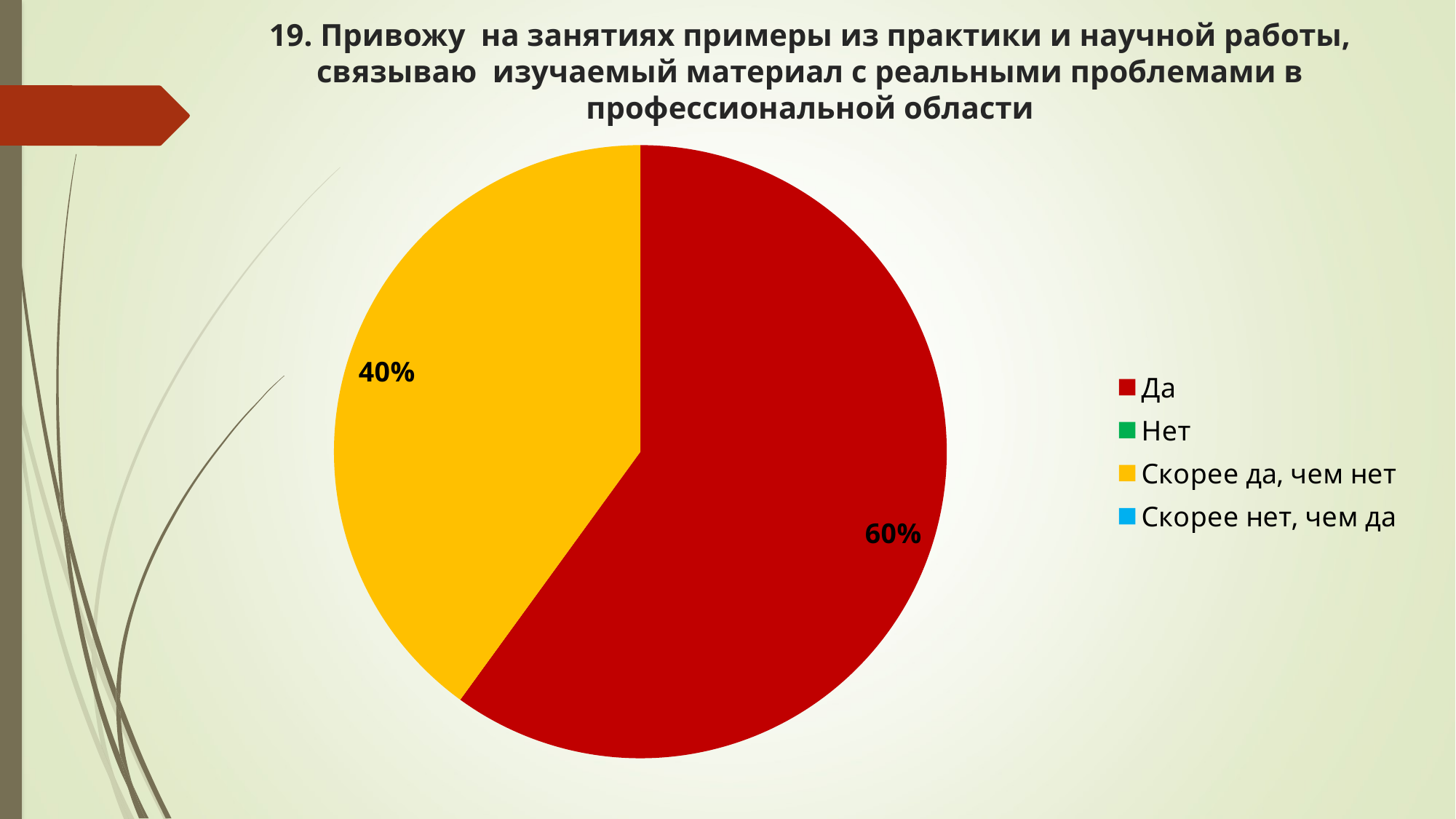
What share of the pie does "Скорее да, чем нет" take? 40% What colour is the slice for "Да"? red How many slices are visible in the pie? 2 What is the difference in percentage points between the "Да" slice and the "Скорее да, чем нет" slice? 20% How many entries does the legend list? 4 Which category has the largest slice of the pie? Да Is the share for "Да" greater or less than 50%? greater What share of the pie does "Да" take? 60% What kind of chart is shown on the slide? pie chart What colour is the slice for "Скорее да, чем нет"? yellow Which is larger, the slice for "Да" or the slice for "Скорее да, чем нет"? Да